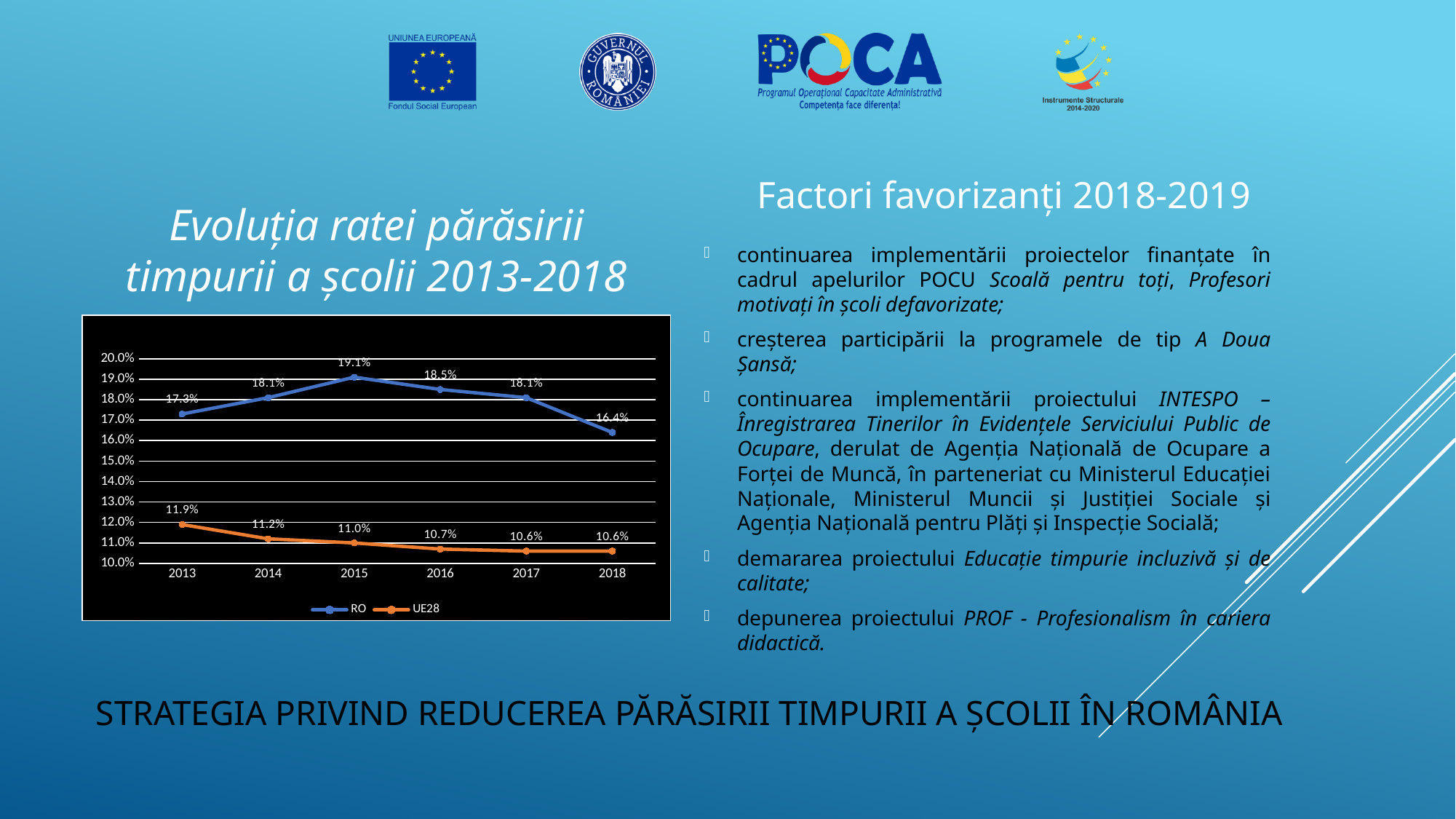
What is the RO value for 2015? 19.1% What is the RO value for 2018? 16.4% Which is larger in 2014, the RO value or the UE28 value? RO How many years are shown on the x axis? 6 In which year is the RO series lowest? 2018 What is the UE28 value for 2013? 11.9% Does the UE28 series rise or fall from 2013 to 2018? fall In which year is the RO series highest? 2015 How many series does the legend list? 2 Is the RO value for 2013 greater or less than 18.0%? less What is the difference between the RO and UE28 values in 2016? 7.8% What kind of chart is shown on the slide? line chart